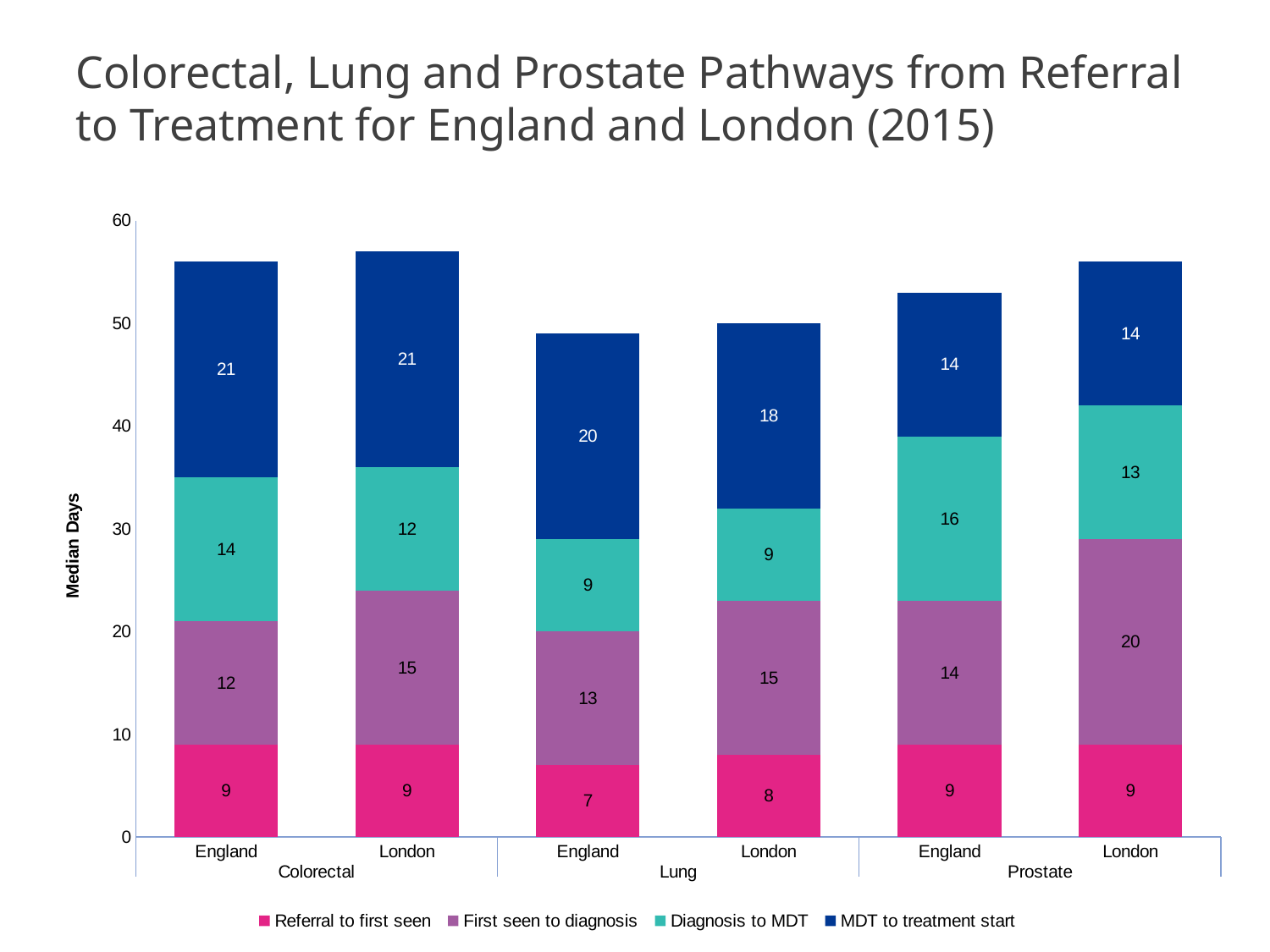
What is the value of 'Referral to first seen' for Lung in England? 7 What is the total of the stacked bar for Lung in England? 49 What kind of chart is shown on the slide? Stacked bar chart What is the total of the stacked bar for Colorectal in London? 57 What is the value of 'MDT to treatment start' for Colorectal in London? 21 Which bar has the lowest 'Referral to first seen' value? Lung, England How many bars are plotted in the chart? 6 How many series does the legend list? 4 What is the value of 'First seen to diagnosis' for Prostate in London? 20 Which is larger: the 'First seen to diagnosis' value for Prostate in London or for Prostate in England? Prostate in London What is the value of 'Diagnosis to MDT' for Prostate in England? 16 What is the difference between the 'MDT to treatment start' values for Lung in England and Lung in London? 2